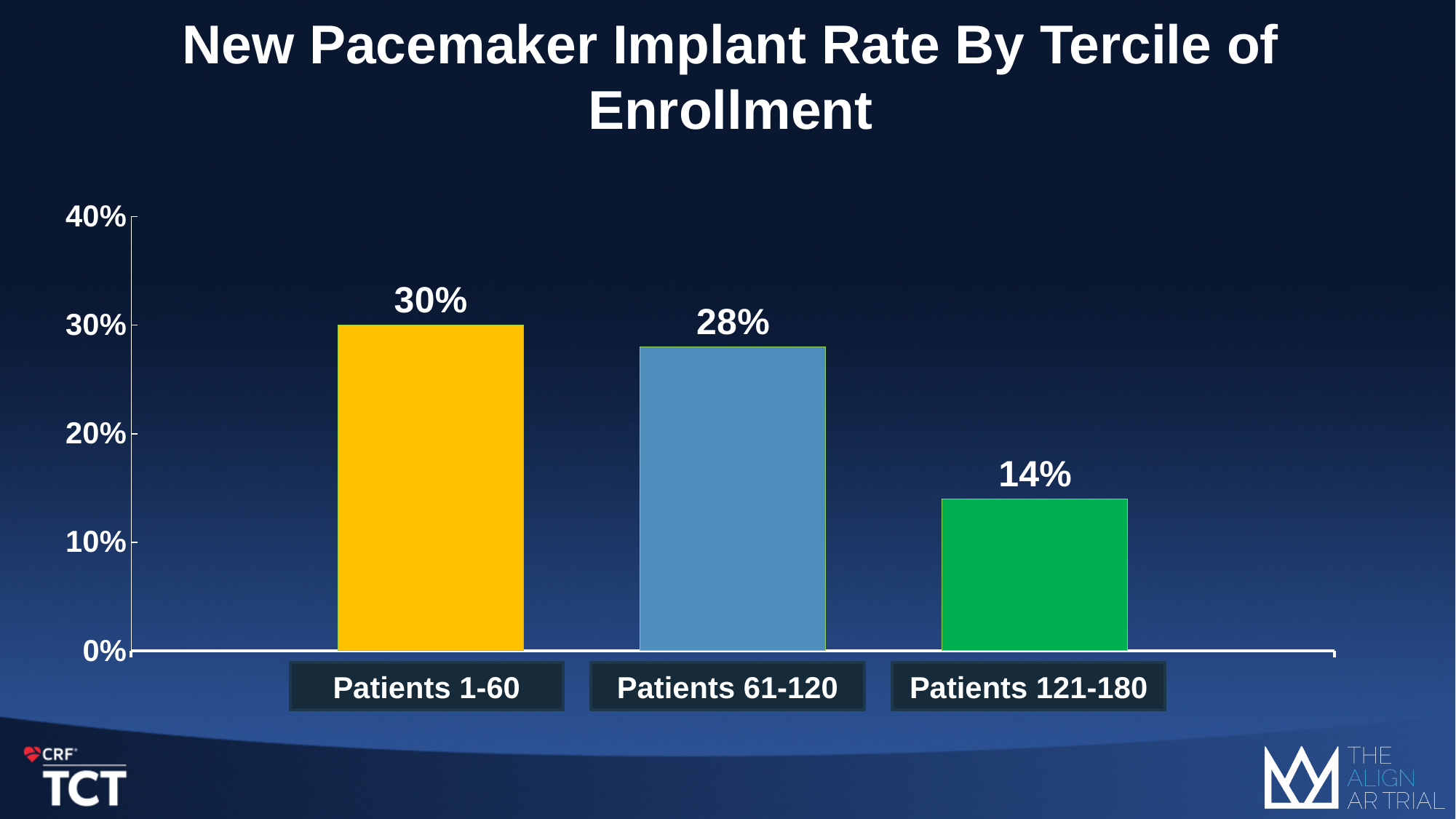
What is the new pacemaker implant rate for Patients 1-60? 30% What is the difference in implant rate between Patients 61-120 and Patients 121-180? 14% How many terciles are shown on the chart? 3 Do the implant rates rise or fall from Patients 1-60 to Patients 121-180? fall What is the new pacemaker implant rate for Patients 61-120? 28% Which has a higher implant rate, Patients 61-120 or Patients 121-180? Patients 61-120 Which tercile has the lowest new pacemaker implant rate? Patients 121-180 What kind of chart is shown on the slide? bar chart What is the new pacemaker implant rate for Patients 121-180? 14% What is the difference in implant rate between Patients 1-60 and Patients 121-180? 16% Is the implant rate for Patients 121-180 greater or less than 20%? less Which tercile has the highest new pacemaker implant rate? Patients 1-60